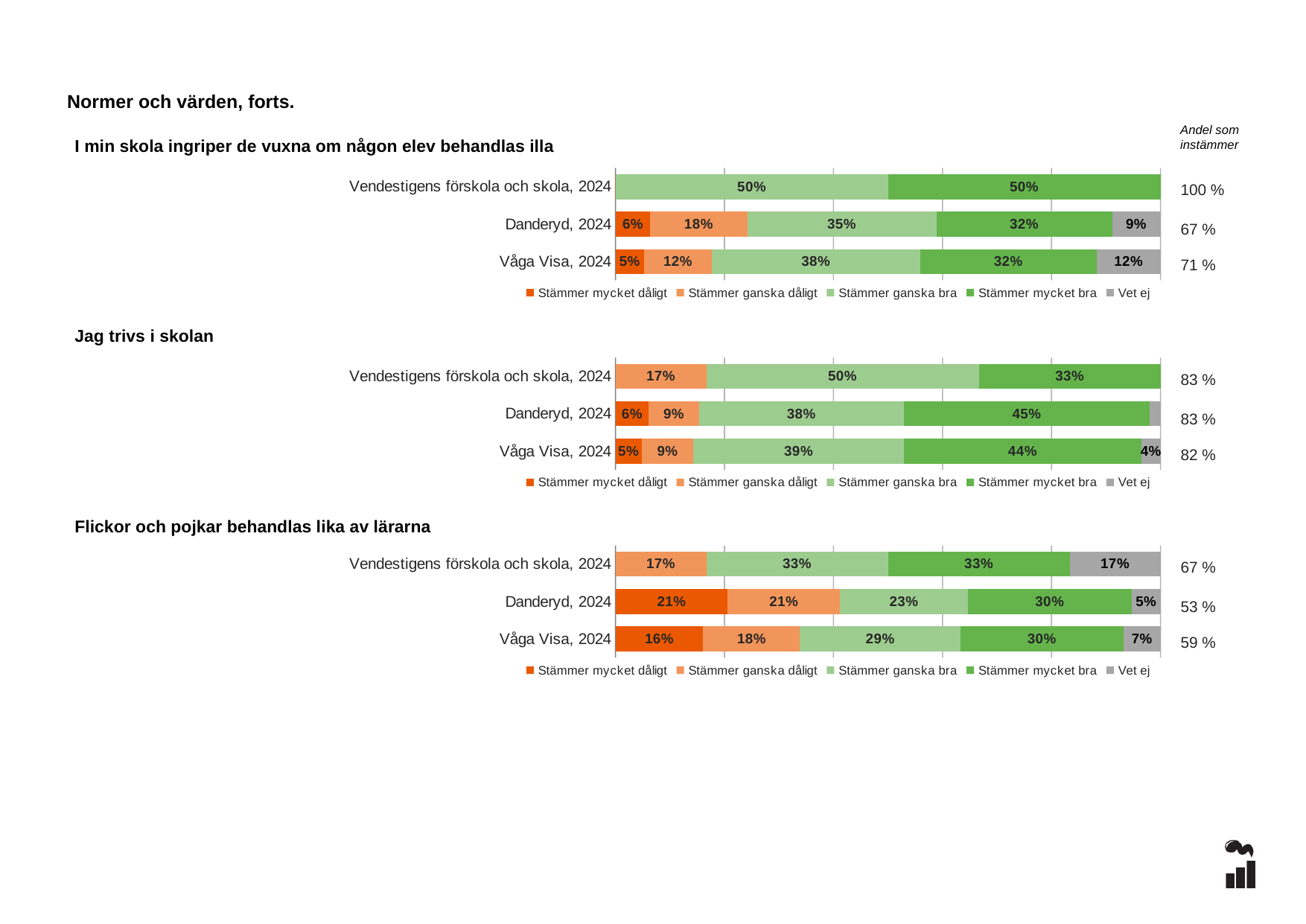
In the chart 'Jag trivs i skolan', what is the difference between the 'Stämmer ganska bra' values for Vendestigens förskola och skola, 2024 and Våga Visa, 2024? 11% In the chart 'Flickor och pojkar behandlas lika av lärarna', what is the 'Andel som instämmer' value for Våga Visa, 2024? 59 % In the chart 'I min skola ingriper de vuxna om någon elev behandlas illa', which row has the highest 'Stämmer mycket bra' value? Vendestigens förskola och skola, 2024 How many rows (categories) are shown in the chart 'Flickor och pojkar behandlas lika av lärarna'? 3 In the chart 'Flickor och pojkar behandlas lika av lärarna', which is larger: the 'Stämmer ganska dåligt' value for Danderyd, 2024 or for Våga Visa, 2024? Danderyd, 2024 In the chart 'I min skola ingriper de vuxna om någon elev behandlas illa', what is the 'Vet ej' value for Våga Visa, 2024? 12% In the chart 'Flickor och pojkar behandlas lika av lärarna', what is the 'Stämmer mycket dåligt' value for Danderyd, 2024? 21% What kind of chart is 'I min skola ingriper de vuxna om någon elev behandlas illa'? Stacked bar chart In the chart 'Jag trivs i skolan', which row has the lowest 'Stämmer mycket bra' value? Vendestigens förskola och skola, 2024 In the chart 'Jag trivs i skolan', what is the 'Stämmer mycket bra' value for Danderyd, 2024? 45% How many series does the legend of the chart 'Jag trivs i skolan' list? 5 In the chart 'I min skola ingriper de vuxna om någon elev behandlas illa', what is the 'Stämmer ganska bra' value for Danderyd, 2024? 35%